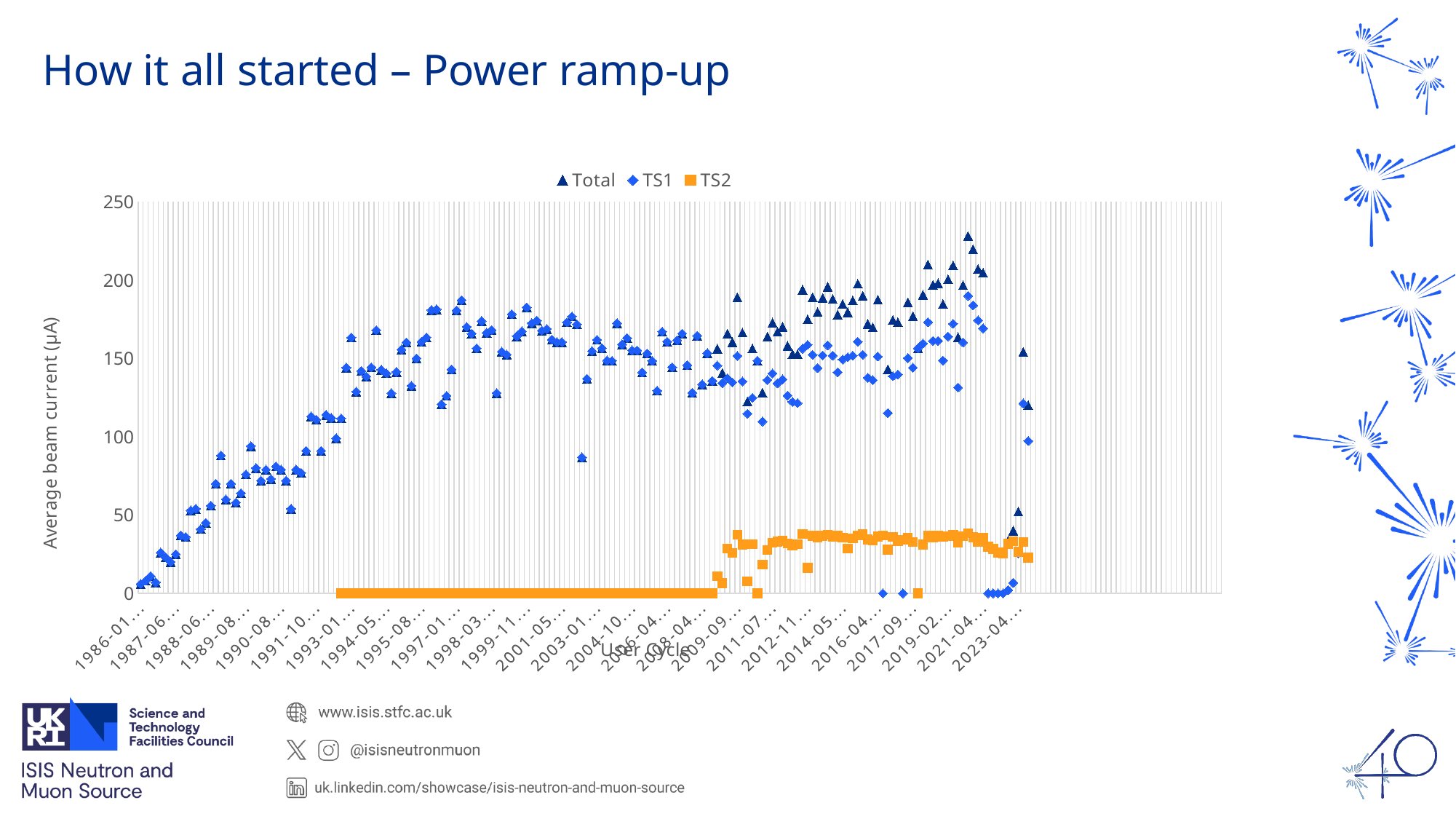
Around 2011-07, which series has the larger value, Total or TS2? Total What kind of chart is shown on the slide? scatter chart Is the Total value at 1986-01 greater or less than 50? less Is the TS2 value around 2014-05 greater or less than 100? less Is the Total value around 1997-01 greater or less than 150? greater What are the names of the series shown in the legend? Total, TS1, TS2 Around 2016-04, which series has the larger value, TS1 or TS2? TS1 How many series does the legend list? 3 Does the Total series rise or fall from 1986-01 to 1994-05? rise What is the title of the vertical axis? Average beam current (µA)